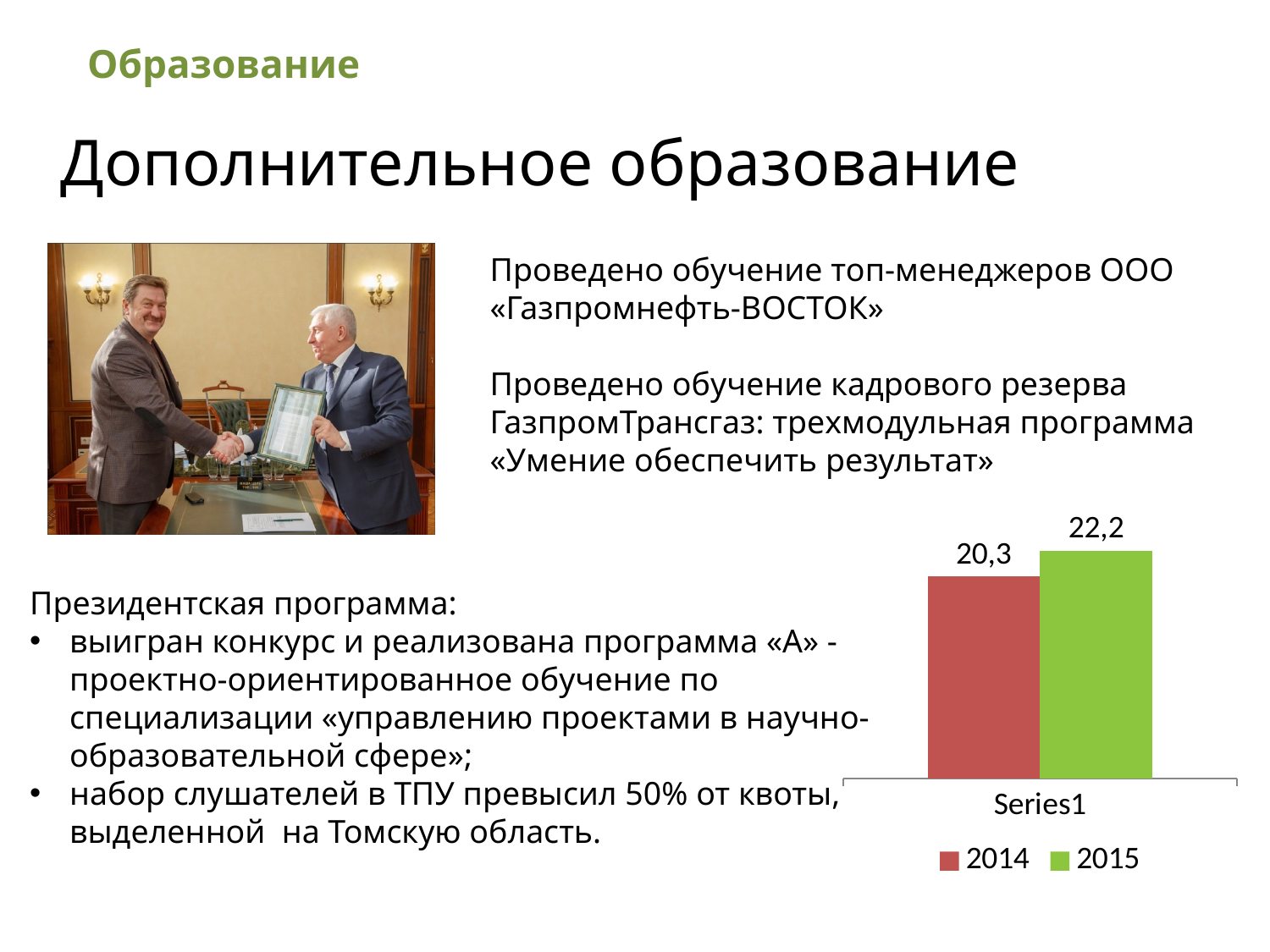
How many bars are plotted in the chart? 2 What is the value for 2015 in the bar chart? 22,2 Is the value for 2015 larger or smaller than the value for 2014 in the bar chart? larger What kind of chart is shown on the slide? bar chart What is the difference between the 2015 and 2014 values in the bar chart? 1,9 How many series does the legend of the bar chart list? 2 Which colour represents 2015 in the bar chart? green What category label is shown on the x axis of the bar chart? Series1 Which year has the lower value in the bar chart? 2014 Which year has the higher value in the bar chart, 2014 or 2015? 2015 What is the value for 2014 in the bar chart? 20,3 Do the values in the chart rise or fall from 2014 to 2015? rise